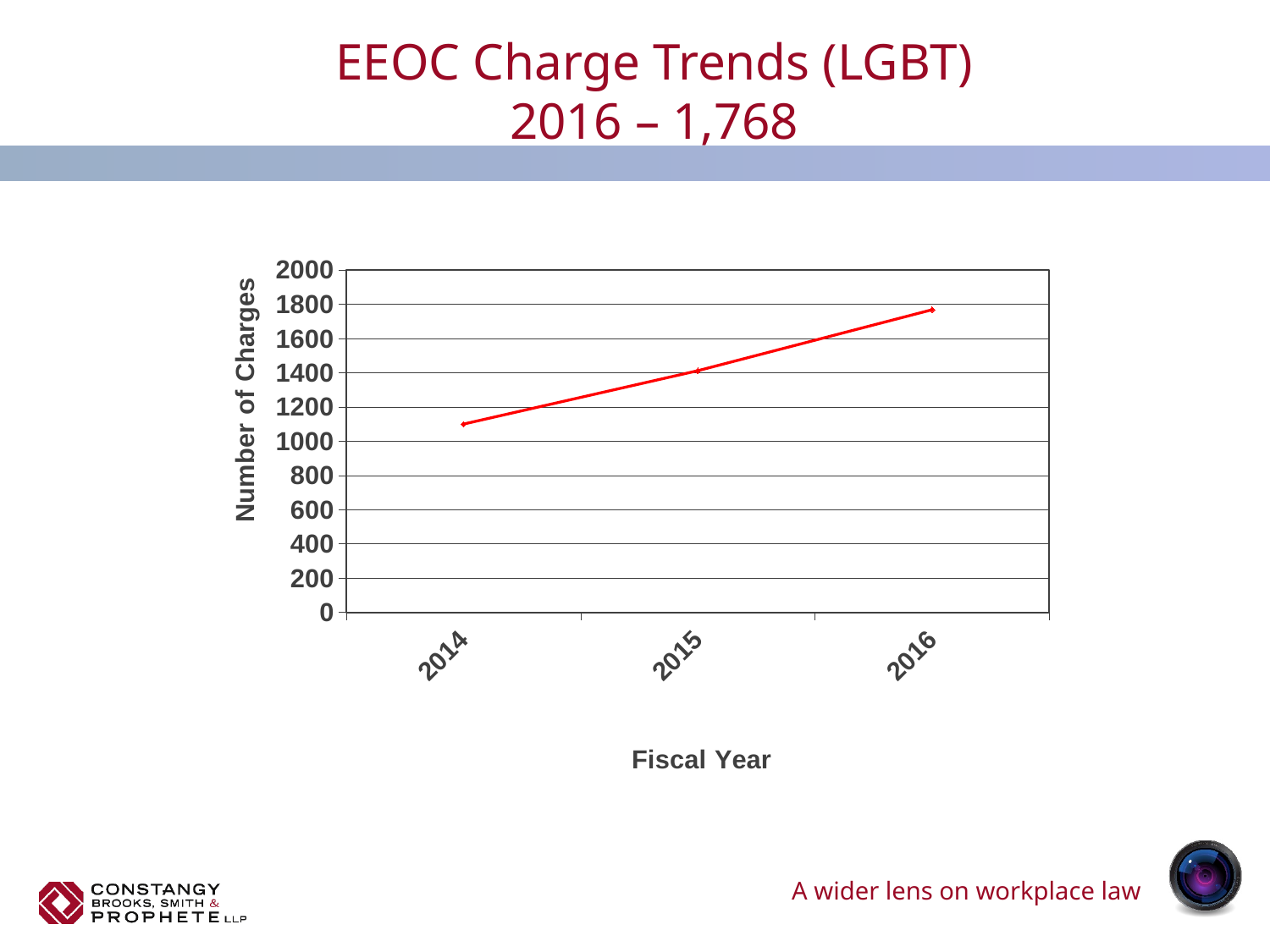
Is the value for 2014 greater or less than 1200? less Is the value for 2014 greater or less than 1000? greater What is the label on the vertical axis of the chart? Number of Charges How many fiscal years are plotted on the chart? 3 Is the value for 2015 greater or less than 1600? less Which is larger, the number of charges in 2015 or in 2014? 2015 What kind of chart is shown on the slide? line chart Which fiscal year has the highest number of charges? 2016 Which fiscal year has the lowest number of charges? 2014 Do the number of charges rise or fall from 2014 to 2016? rise What is the number of charges for fiscal year 2016? 1,768